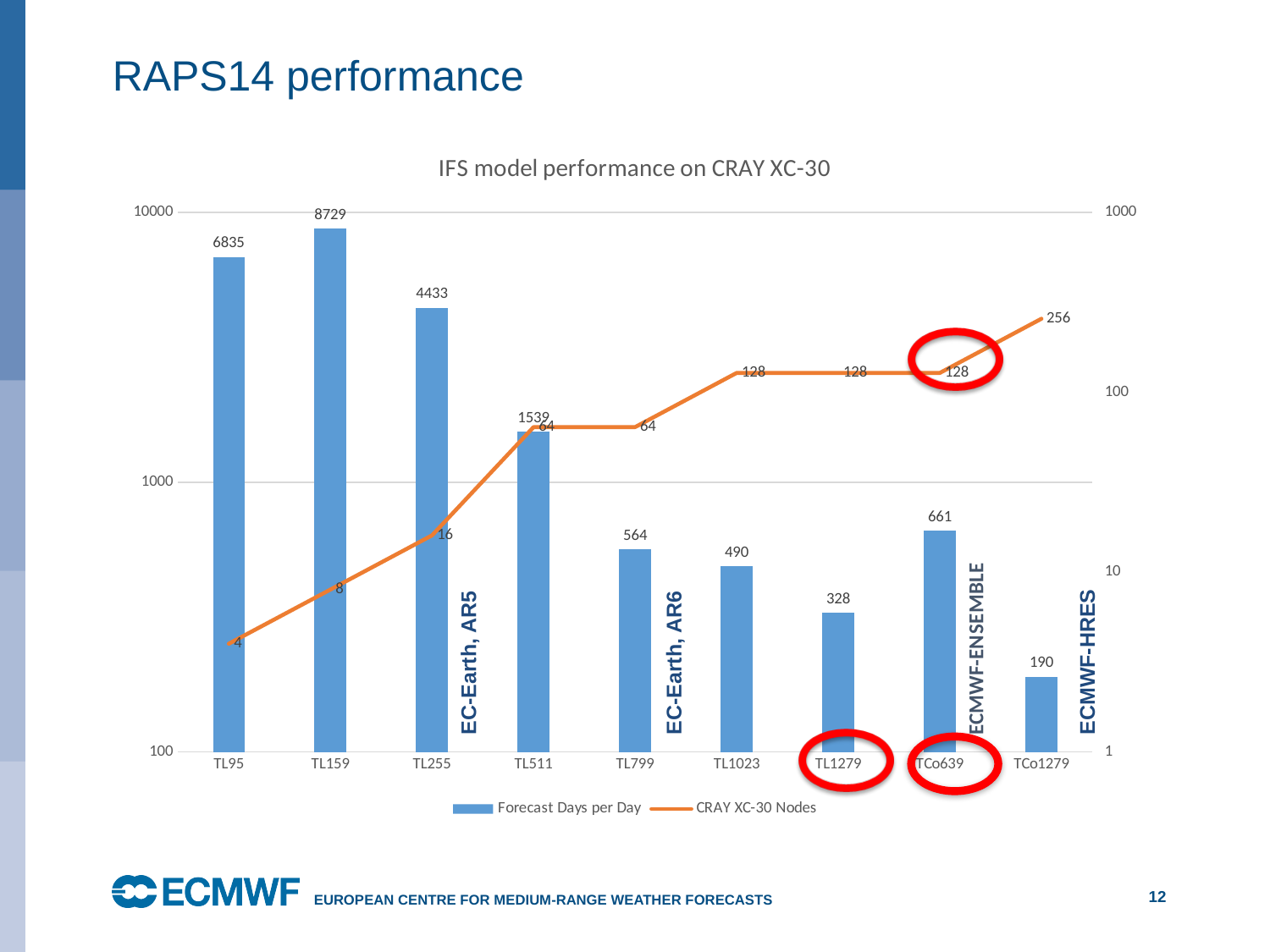
What is the Forecast Days per Day value for TL159? 8729 What kind of chart is this? bar and line chart How many categories are shown on the x axis? 9 What is the title of the chart? IFS model performance on CRAY XC-30 Which category has the highest Forecast Days per Day? TL159 Which category has the lowest Forecast Days per Day? TCo1279 How many CRAY XC-30 Nodes are shown for TCo1279? 256 How many CRAY XC-30 Nodes are shown for TL255? 16 How many series does the legend list? 2 Which has more Forecast Days per Day, TL799 or TL1023? TL799 What is the difference in Forecast Days per Day between TL95 and TL255? 2402 What is the Forecast Days per Day value for TCo639? 661